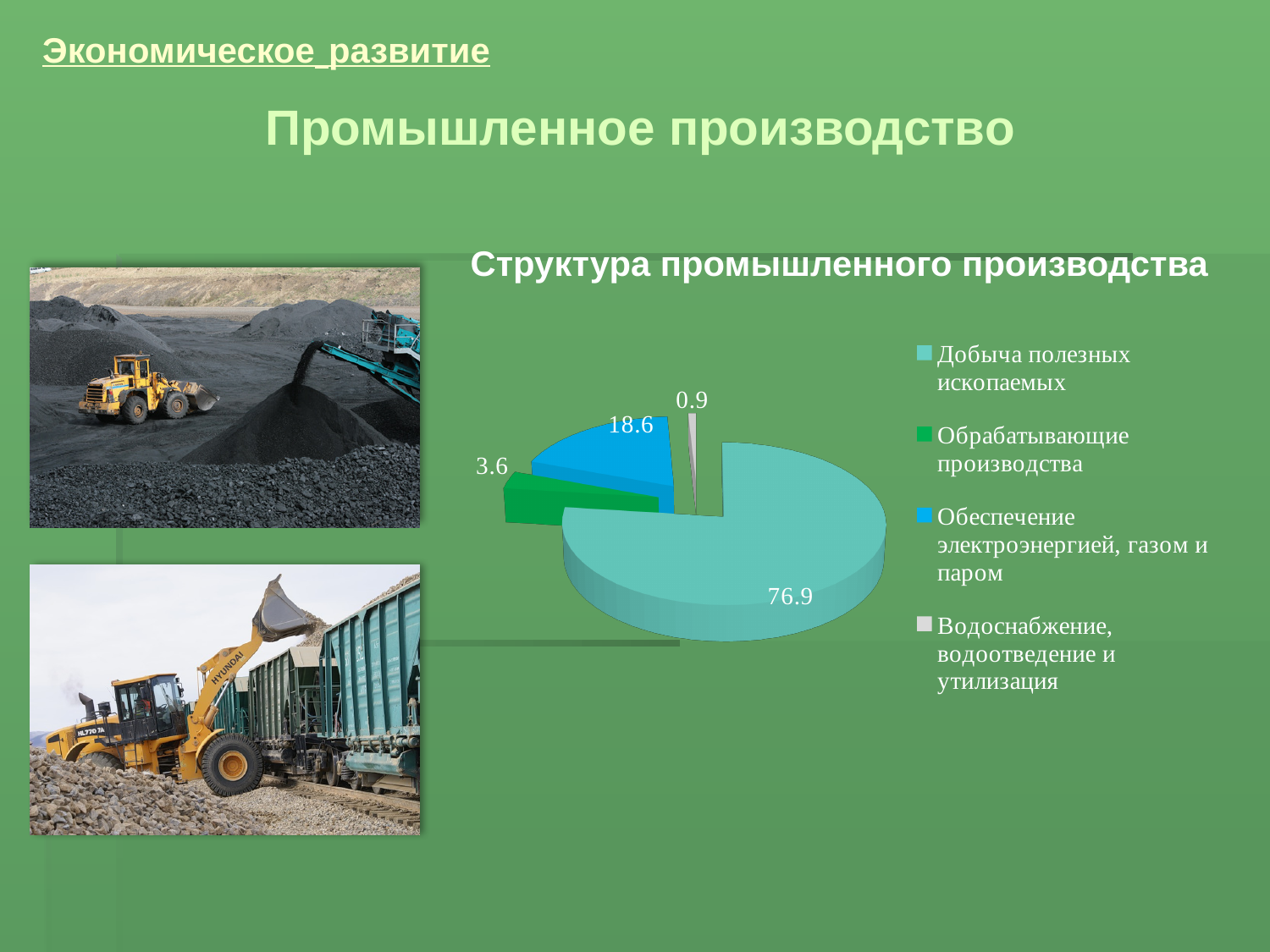
What is the value for Добыча полезных ископаемых in the pie chart? 76.9 What is the value for Водоснабжение, водоотведение и утилизация in the pie chart? 0.9 What is the title of the pie chart? Структура промышленного производства What colour is the slice for Обрабатывающие производства in the pie chart? Green Which category has the largest slice in the pie chart? Добыча полезных ископаемых What type of chart is shown on the slide? Pie chart What is the value for Обеспечение электроэнергией, газом и паром in the pie chart? 18.6 What is the difference between the values for Добыча полезных ископаемых and Обеспечение электроэнергией, газом и паром? 58.3 Which category has the smallest slice in the pie chart? Водоснабжение, водоотведение и утилизация Which is larger: the value for Обрабатывающие производства or the value for Обеспечение электроэнергией, газом и паром? Обеспечение электроэнергией, газом и паром What is the value for Обрабатывающие производства in the pie chart? 3.6 How many categories does the pie chart show? 4